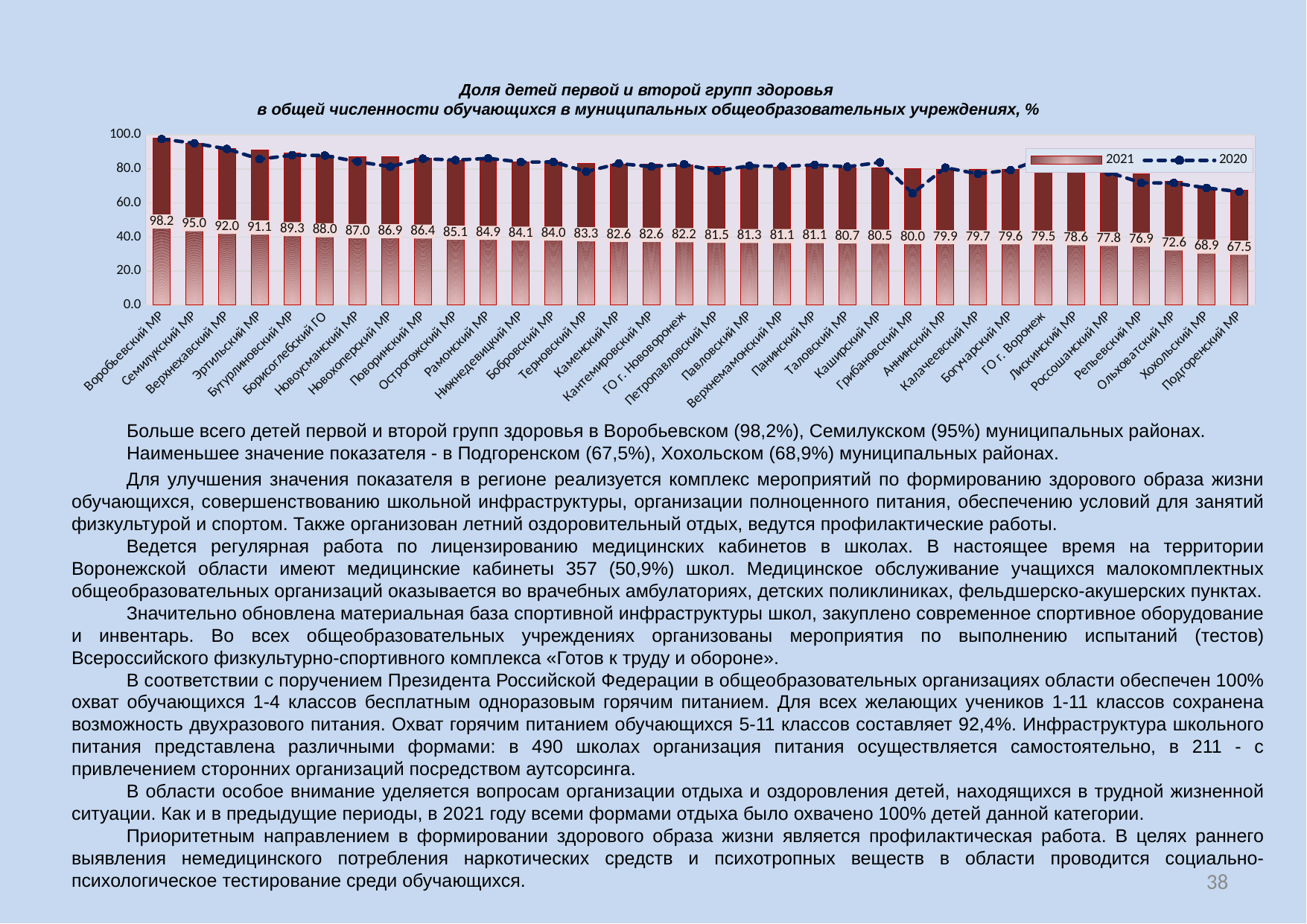
How many districts are shown on the x axis? 34 What is the 2021 value for ГО г. Воронеж? 79.5 Which district has the lowest 2021 value? Подгоренский МР What is the 2021 value for Семилукский МР? 95.0 Which district has the highest 2021 value? Воробьевский МР What is the difference between the 2021 values for Воробьевский МР and Подгоренский МР? 30.7 Is the 2020 value for Грибановский МР greater or less than 80.0? less What is the 2021 value for Борисоглебский ГО? 88.0 Which has a higher 2021 value, Ольховатский МР or Репьевский МР? Репьевский МР What kind of chart is this? Bar chart with a line Do the 2021 values rise or fall from left to right along the x axis? fall How many series does the legend list? 2